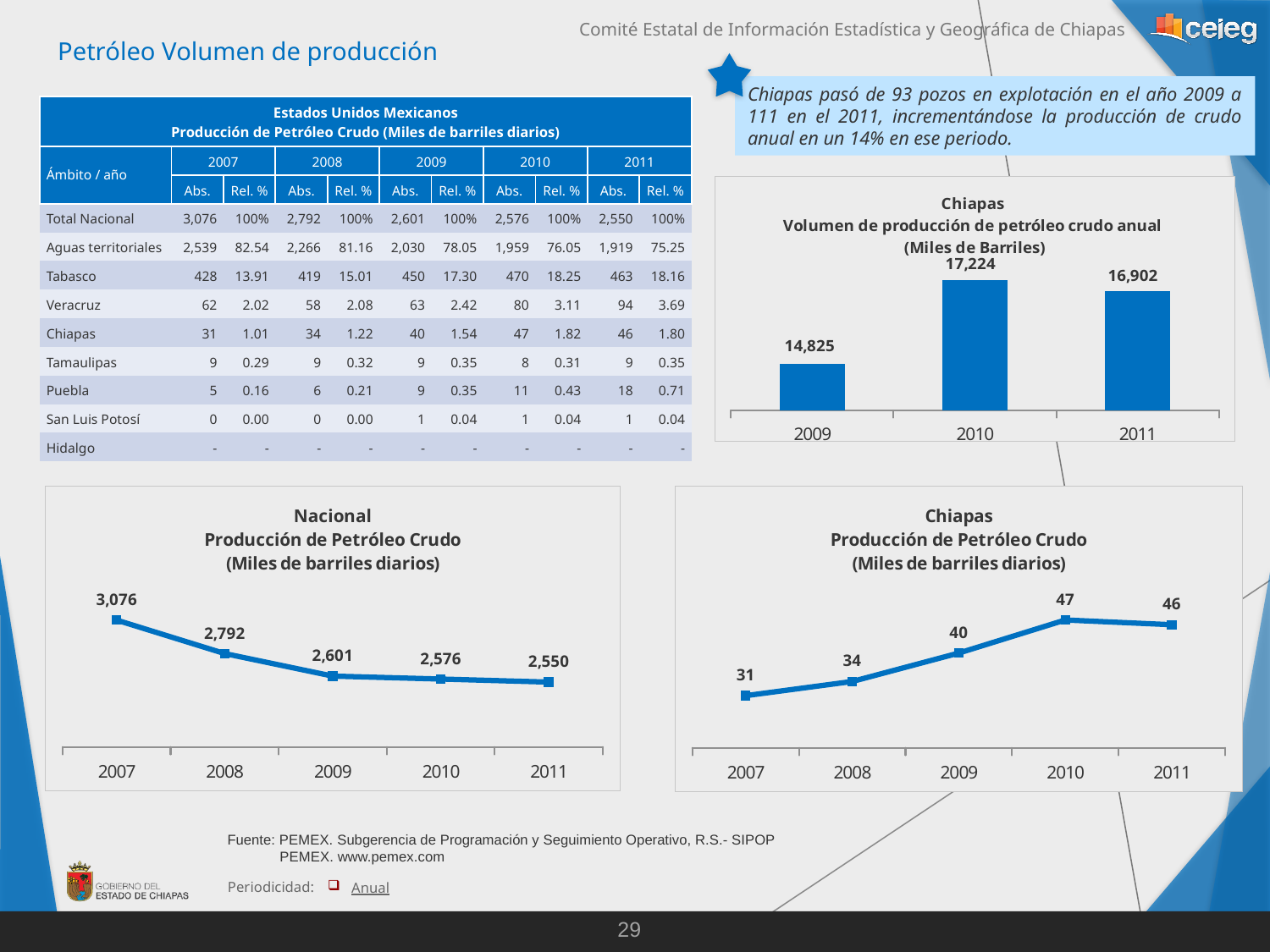
In the 'Chiapas Producción de Petróleo Crudo (Miles de barriles diarios)' line chart, which year has the highest value? 2010 In the 'Chiapas Volumen de producción de petróleo crudo anual' bar chart, which year has the lowest value? 2009 In the 'Nacional Producción de Petróleo Crudo' line chart, what is the value for 2008? 2,792 What kind of chart is the 'Chiapas Volumen de producción de petróleo crudo anual' chart? Bar chart How many years are plotted in the 'Nacional Producción de Petróleo Crudo' line chart? 5 In the 'Nacional Producción de Petróleo Crudo' line chart, do the values rise or fall from 2007 to 2011? Fall In the 'Chiapas Volumen de producción de petróleo crudo anual' bar chart, what is the value for 2010? 17,224 What kind of chart is the 'Chiapas Producción de Petróleo Crudo (Miles de barriles diarios)' chart? Line chart In the 'Nacional Producción de Petróleo Crudo' line chart, what is the difference between the 2007 and 2011 values? 526 In the 'Chiapas Volumen de producción de petróleo crudo anual' bar chart, what is the difference between the 2010 and 2011 values? 322 In the 'Chiapas Producción de Petróleo Crudo (Miles de barriles diarios)' line chart, what is the value for 2009? 40 In the 'Chiapas Producción de Petróleo Crudo (Miles de barriles diarios)' line chart, which is larger, the value for 2008 or the value for 2011? 2011